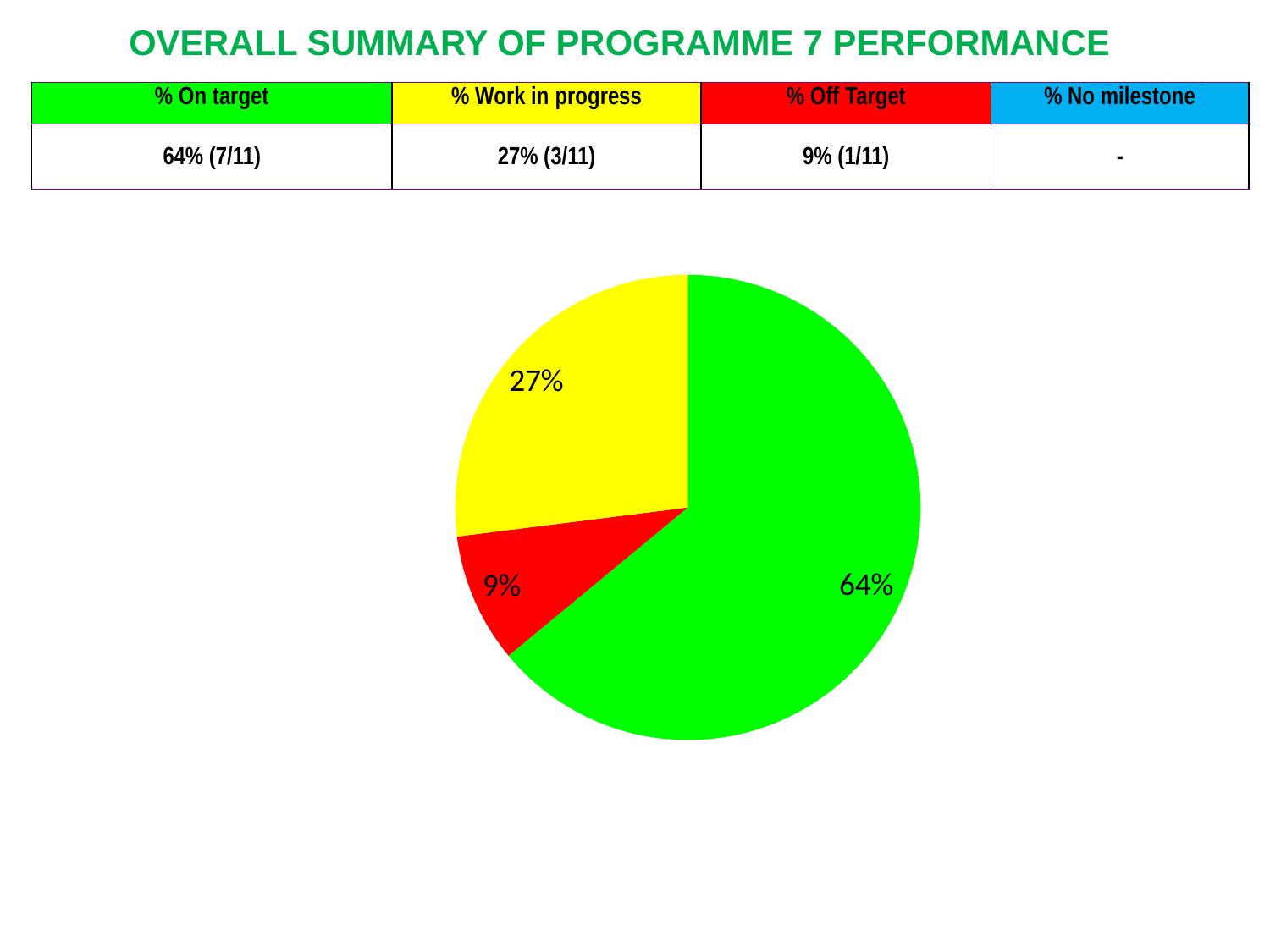
What percentage is shown on the green slice of the pie chart? 64% What is the difference between the yellow slice and the red slice of the pie chart? 18% What percentage is shown on the red slice of the pie chart? 9% How many slices does the pie chart have? 3 Which is larger in the pie chart, the yellow slice or the red slice? the yellow slice What is the difference between the green slice and the yellow slice of the pie chart? 37% What share of the pie does the green slice represent? 64% What is the title of the slide containing the pie chart? OVERALL SUMMARY OF PROGRAMME 7 PERFORMANCE Which slice of the pie chart is the largest? the green slice (64%) What kind of chart is shown on the slide? pie chart Which slice of the pie chart is the smallest? the red slice (9%) What percentage is shown on the yellow slice of the pie chart? 27%